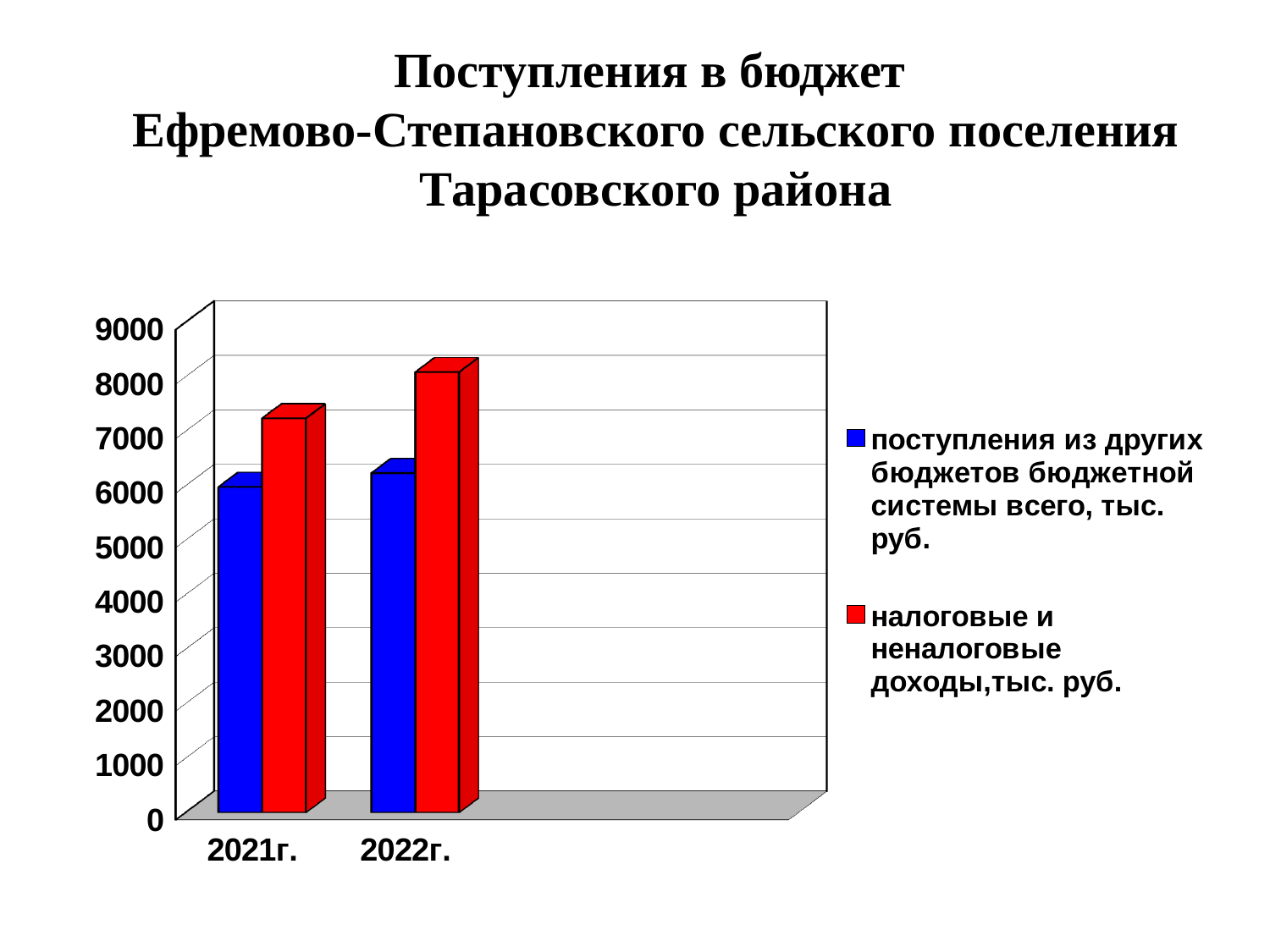
Which bar is the highest on the chart? налоговые и неналоговые доходы in 2022г. Do the values for 'налоговые и неналоговые доходы' rise or fall from 2021г. to 2022г.? rise Is the value for 'поступления из других бюджетов бюджетной системы всего' in 2022г. greater or less than 5000? greater In 2022г., which series has the larger value: 'поступления из других бюджетов' or 'налоговые и неналоговые доходы'? налоговые и неналоговые доходы What kind of chart is shown on the slide? bar chart Is the value for 'налоговые и неналоговые доходы' in 2021г. greater or less than 6000? greater Is the value for 'поступления из других бюджетов бюджетной системы всего' in 2021г. greater or less than 7000? less Which years are shown on the x axis? 2021г. and 2022г. How many categories (years) are shown on the x axis? 2 Which colour represents 'налоговые и неналоговые доходы, тыс. руб.' in the legend? red How many series does the legend list? 2